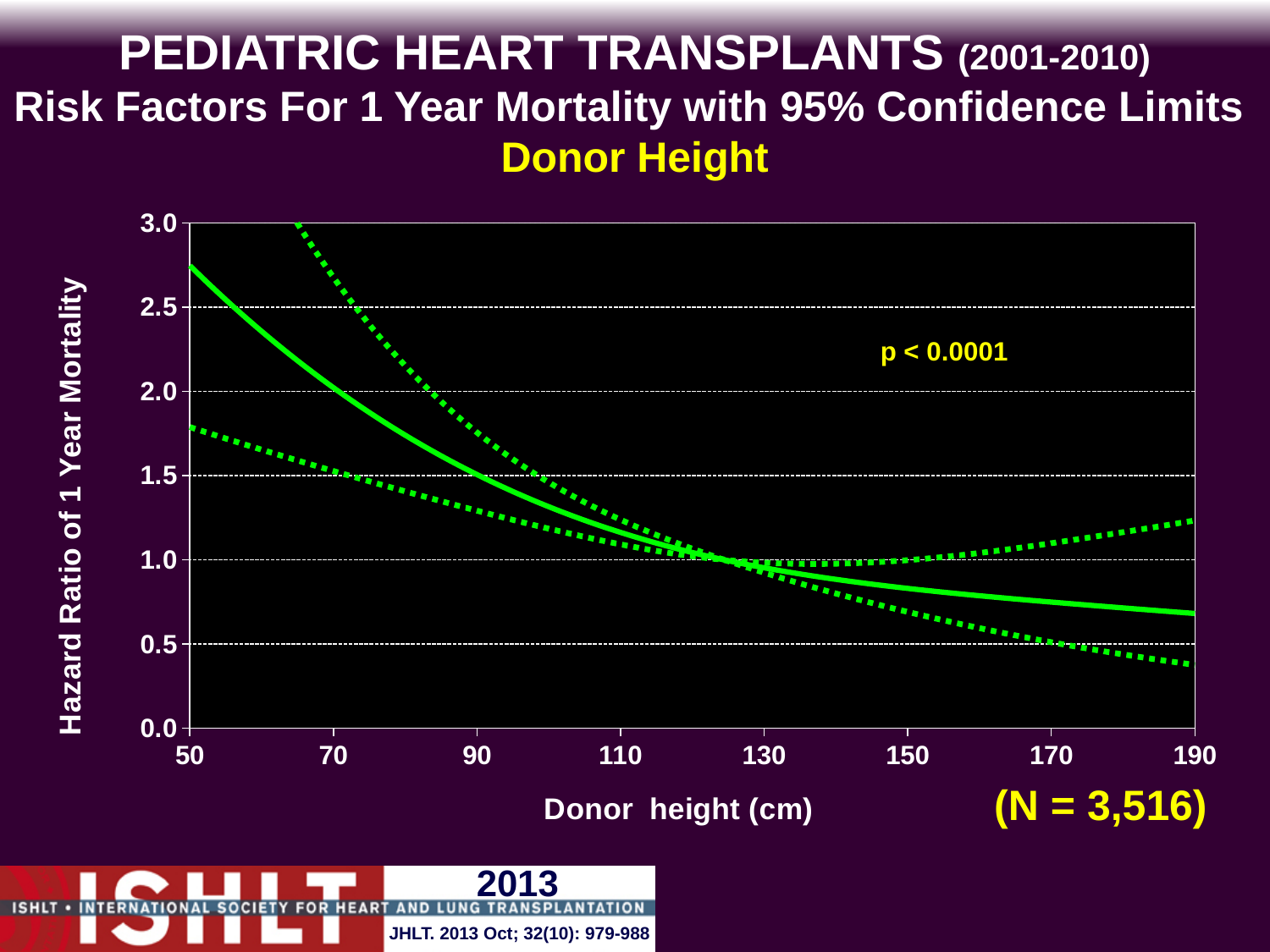
What is the sample size (N) shown on the slide? 3,516 What kind of chart is shown on the slide? line chart Is the hazard ratio (solid line) higher at a donor height of 50 cm or at 190 cm? 50 cm How many lines are plotted on the chart? 3 Does the hazard ratio of 1 year mortality rise or fall as donor height increases from 50 to 190 cm? fall Is the upper 95% confidence limit (upper dotted line) at a donor height of 190 cm greater or less than 1.0? greater Is the hazard ratio (solid line) at a donor height of 150 cm greater or less than 1.0? less Is the hazard ratio (solid line) at a donor height of 50 cm greater or less than 2.5? greater What p-value is shown on the chart? p < 0.0001